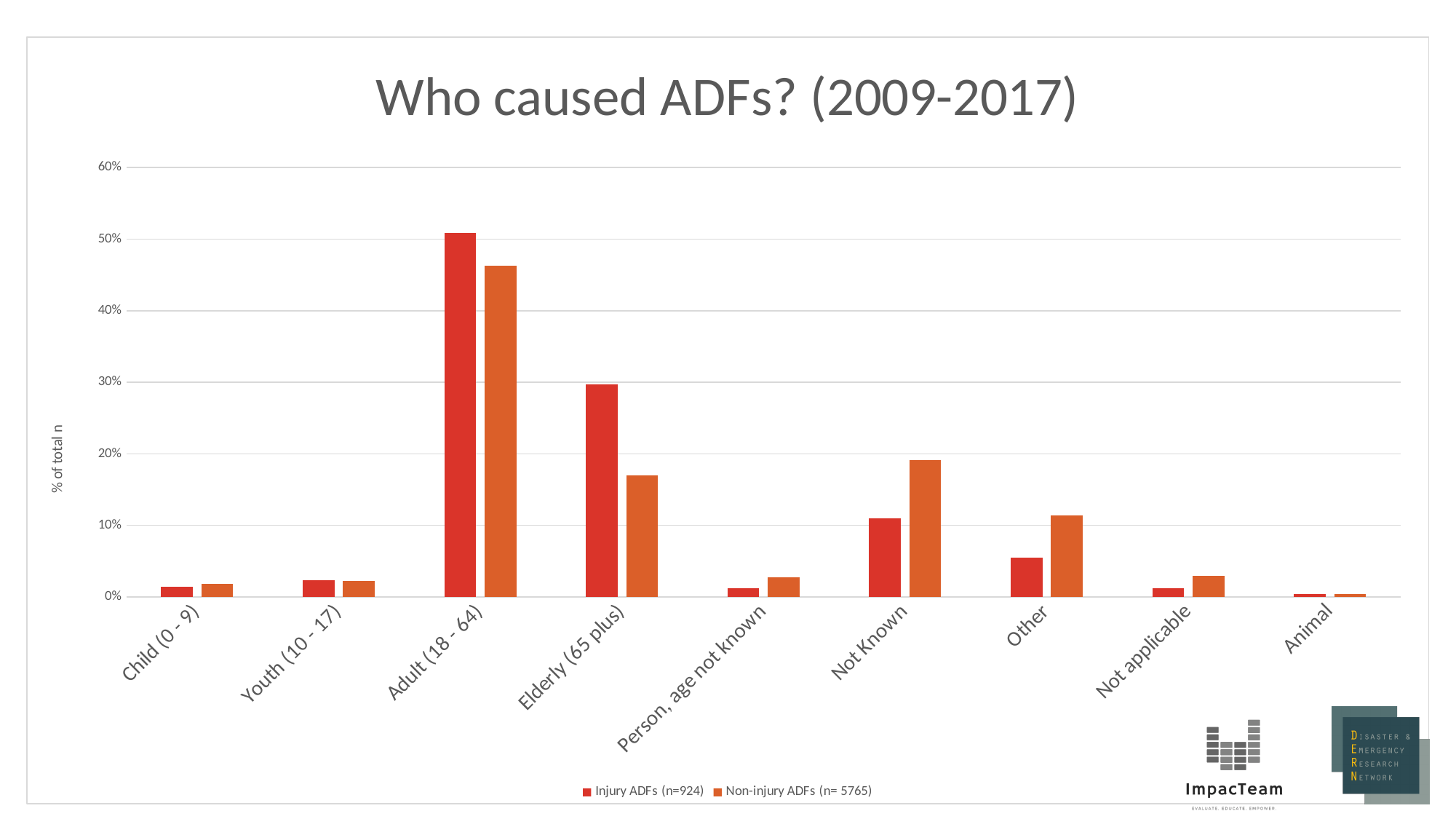
Is the Injury ADFs value for Other greater or less than 10%? less For Not Known, which series has the larger value, Injury ADFs or Non-injury ADFs? Non-injury ADFs What is the title of the chart? Who caused ADFs? (2009-2017) Is the Non-injury ADFs value for Adult (18 - 64) greater or less than 50%? less For Elderly (65 plus), which series has the larger value, Injury ADFs or Non-injury ADFs? Injury ADFs What kind of chart is shown on the slide? bar chart Is the Injury ADFs value for Adult (18 - 64) greater or less than 40%? greater How many categories are shown on the x axis? 9 Which category has the highest value for Injury ADFs? Adult (18 - 64) How many series does the legend list? 2 Which category has the lowest value for Non-injury ADFs? Animal